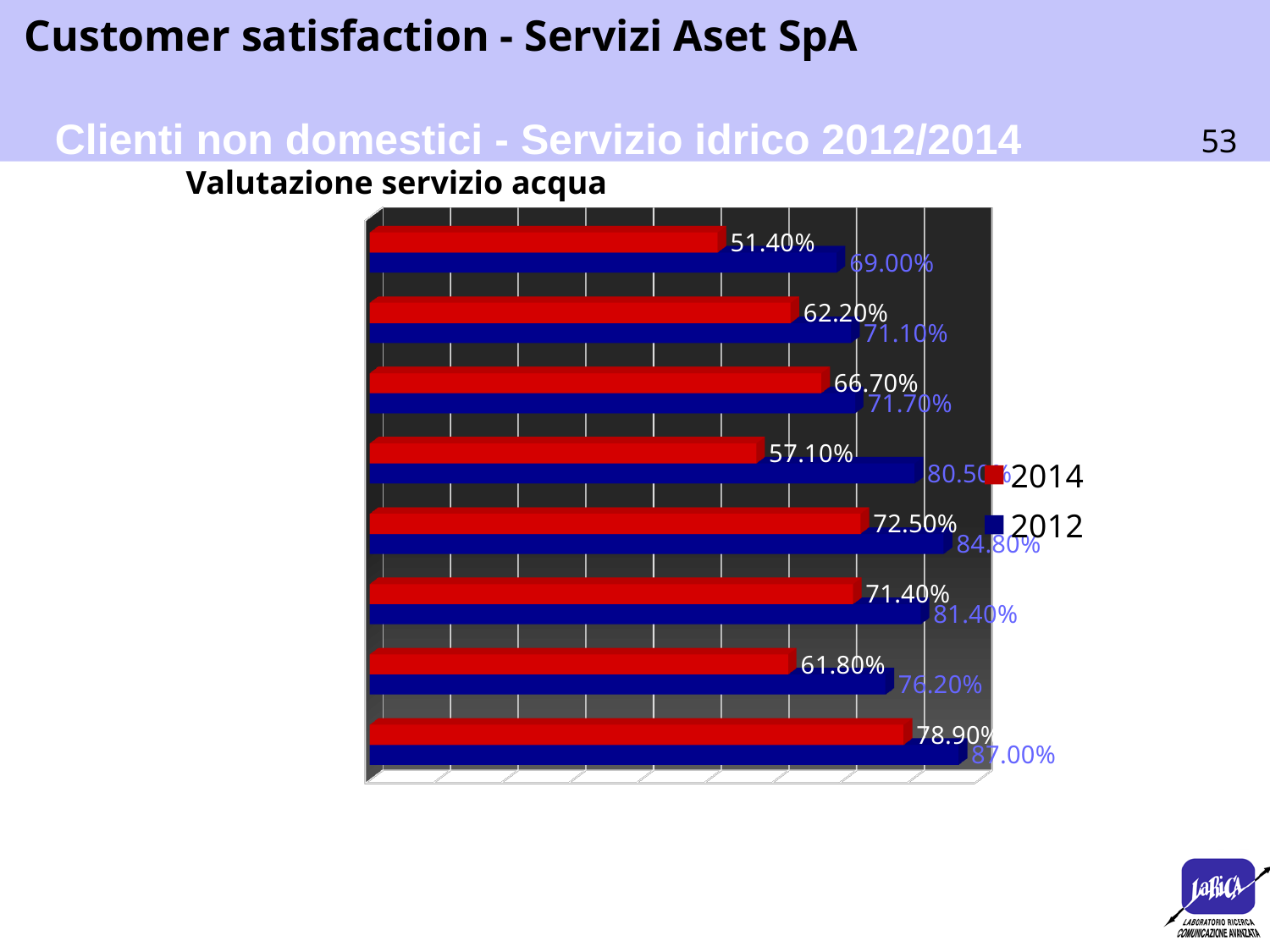
What is the title shown above the chart? Valutazione servizio acqua How many series does the legend list? 2 Which two years are listed in the chart legend? 2014 and 2012 What is the highest value among the 2014 bars? 78.90% What is the lowest value among the 2014 bars? 51.40% How many pairs of bars (categories) are plotted in the chart? 8 In the bottom pair of bars, what is the difference between the 2012 value and the 2014 value? 8.10 percentage points What kind of chart is shown on the slide? bar chart In the top pair of bars, which series has the larger value, 2014 or 2012? 2012 What is the value of the bottommost blue (2012) bar? 87.00% What is the value of the topmost red (2014) bar? 51.40% What is the lowest value among the 2012 bars? 69.00%